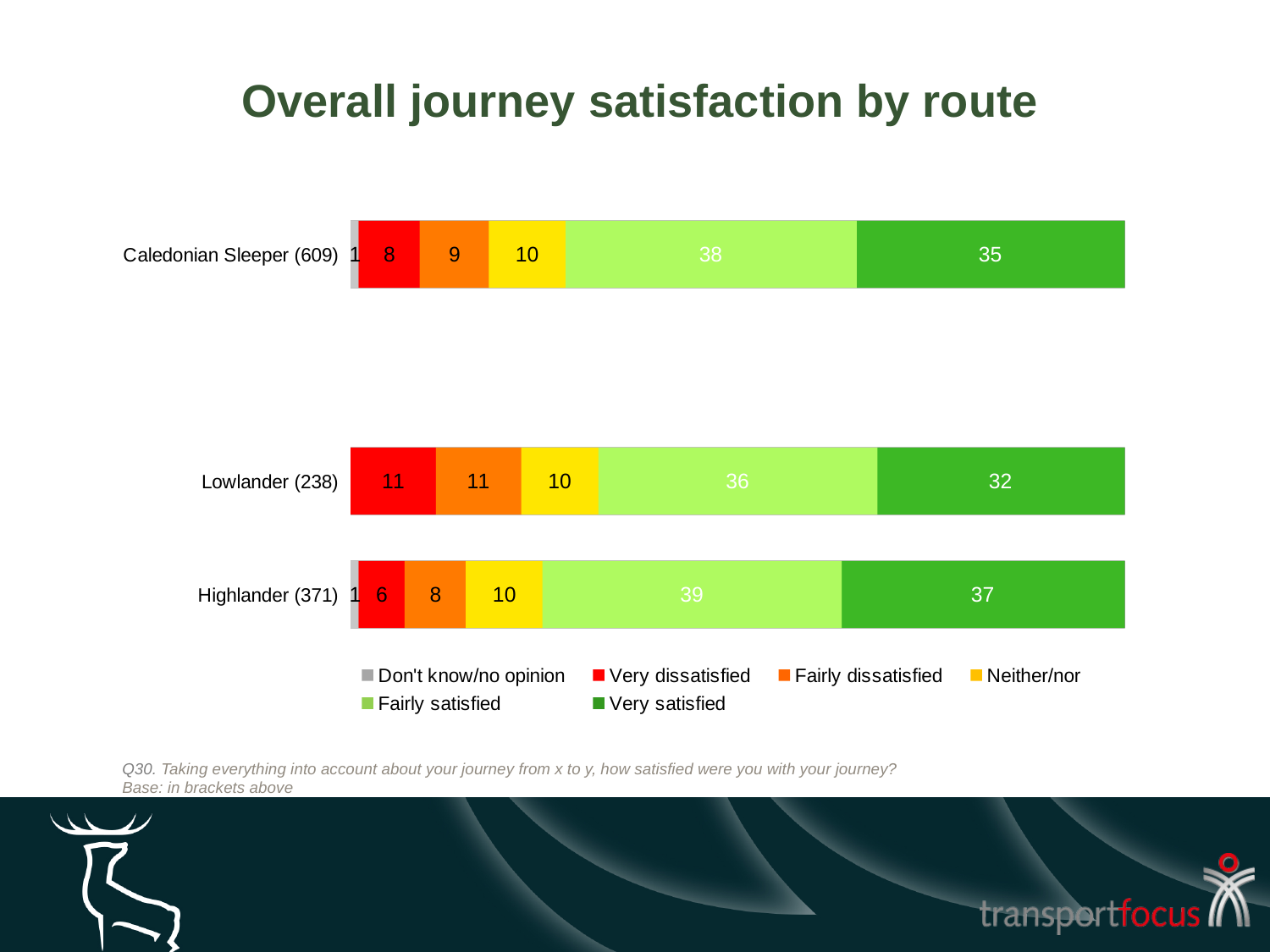
What is the Fairly satisfied value for Lowlander (238)? 36 What is the difference between the Fairly dissatisfied values for Lowlander (238) and Caledonian Sleeper (609)? 2 Which route has the lowest Fairly satisfied value? Lowlander (238) What is the Very dissatisfied value for Caledonian Sleeper (609)? 8 Which has the larger Very dissatisfied value, Lowlander (238) or Highlander (371)? Lowlander (238) How many series does the legend list? 6 Which route has the highest Very satisfied value? Highlander (371) What is the Neither/nor value for Highlander (371)? 10 What is the Very satisfied value for Highlander (371)? 37 How many routes are shown in the chart? 3 What is the difference between the Very satisfied values for Highlander (371) and Lowlander (238)? 5 What kind of chart is shown on the slide? Stacked bar chart